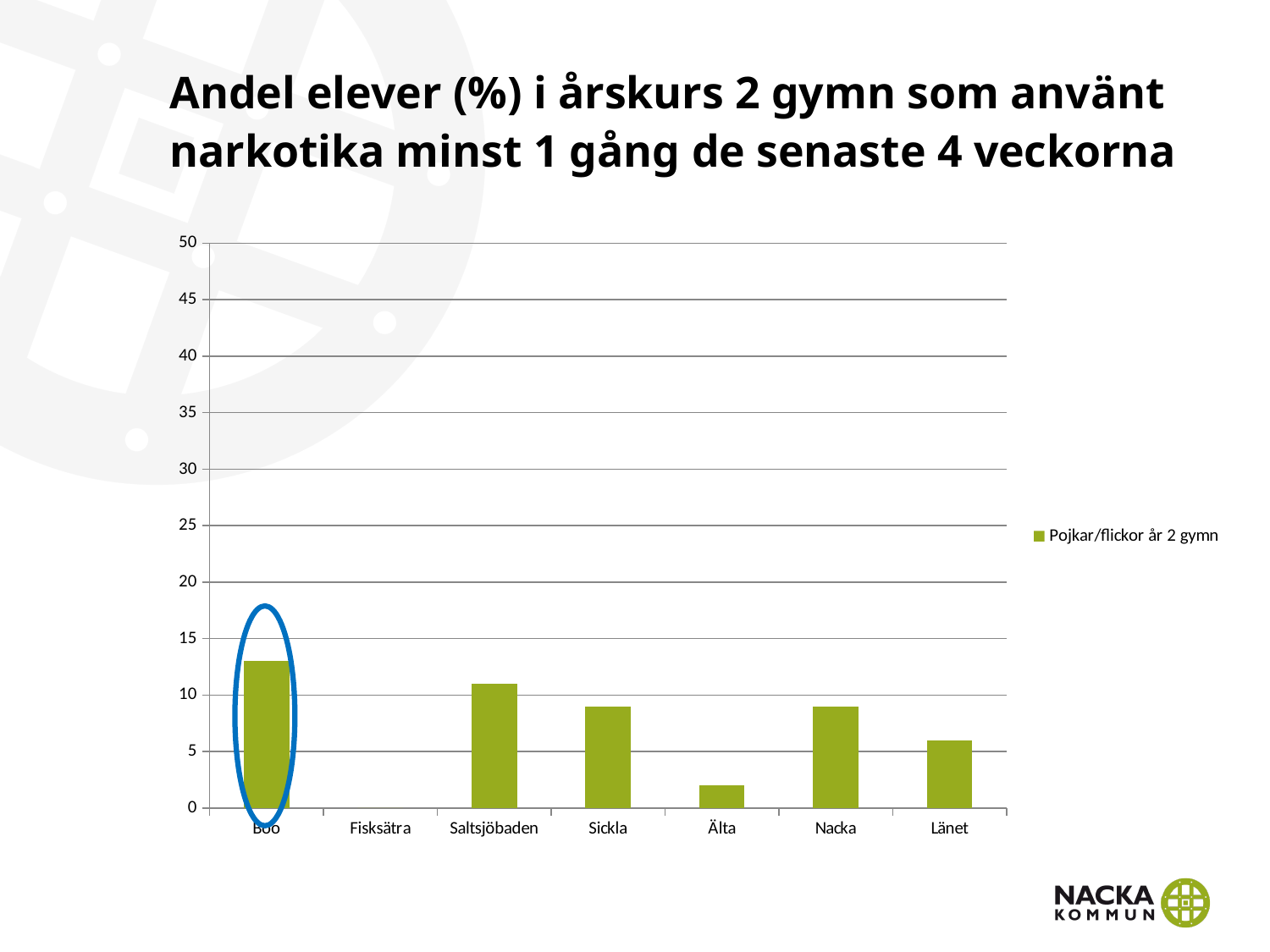
How many series does the legend list? 1 Which is larger, the value for Länet or the value for Älta? Länet Which category's bar is circled in blue on the chart? Boo Which category has the highest bar in the chart? Boo What is the series name shown in the chart legend? Pojkar/flickor år 2 gymn Is the value for Nacka greater or less than 10? less What kind of chart is shown on the slide? bar chart How many categories are shown on the x axis of the chart? 7 Which is larger, the value for Boo or the value for Saltsjöbaden? Boo Is the value for Älta greater or less than 5? less Is the value for Boo greater or less than 10? greater